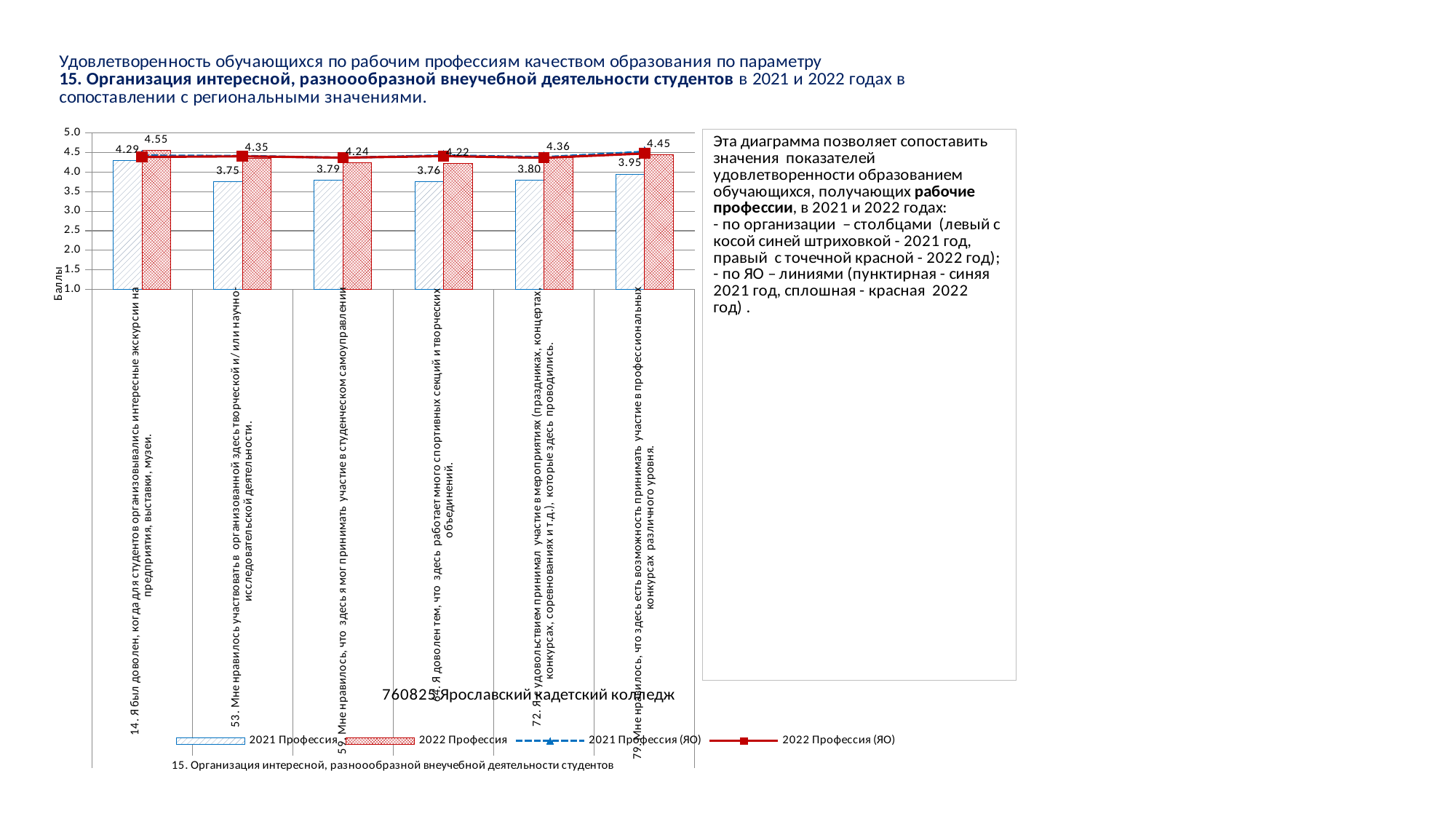
What is the difference between the 2022 Профессия and 2021 Профессия values for category 14? 0.26 What is the value of the 2021 Профессия bar for category 79 (Мне нравилось, что здесь есть возможность принимать участие в профессиональных конкурсах различного уровня)? 3.95 What is the value of the 2022 Профессия bar for category 53 (Мне нравилось участвовать в организованной здесь творческой и/или научно исследовательской деятельности)? 4.35 What is the value of the 2021 Профессия bar for category 14 (Я был доволен, когда для студентов организовывались интересные экскурсии на предприятия, выставки, музеи)? 4.29 Which category has the highest 2022 Профессия bar? 14. Я был доволен, когда для студентов организовывались интересные экскурсии на предприятия, выставки, музеи. What kind of chart is shown on the slide? Combined bar and line chart Is the 2021 Профессия value for category 72 greater or less than 4.0? less What is the difference between the 2022 Профессия and 2021 Профессия values for category 79? 0.50 How many categories are shown on the x axis of the chart? 6 How many series does the chart legend list? 4 Which category has the highest 2021 Профессия bar? 14. Я был доволен, когда для студентов организовывались интересные экскурсии на предприятия, выставки, музеи.